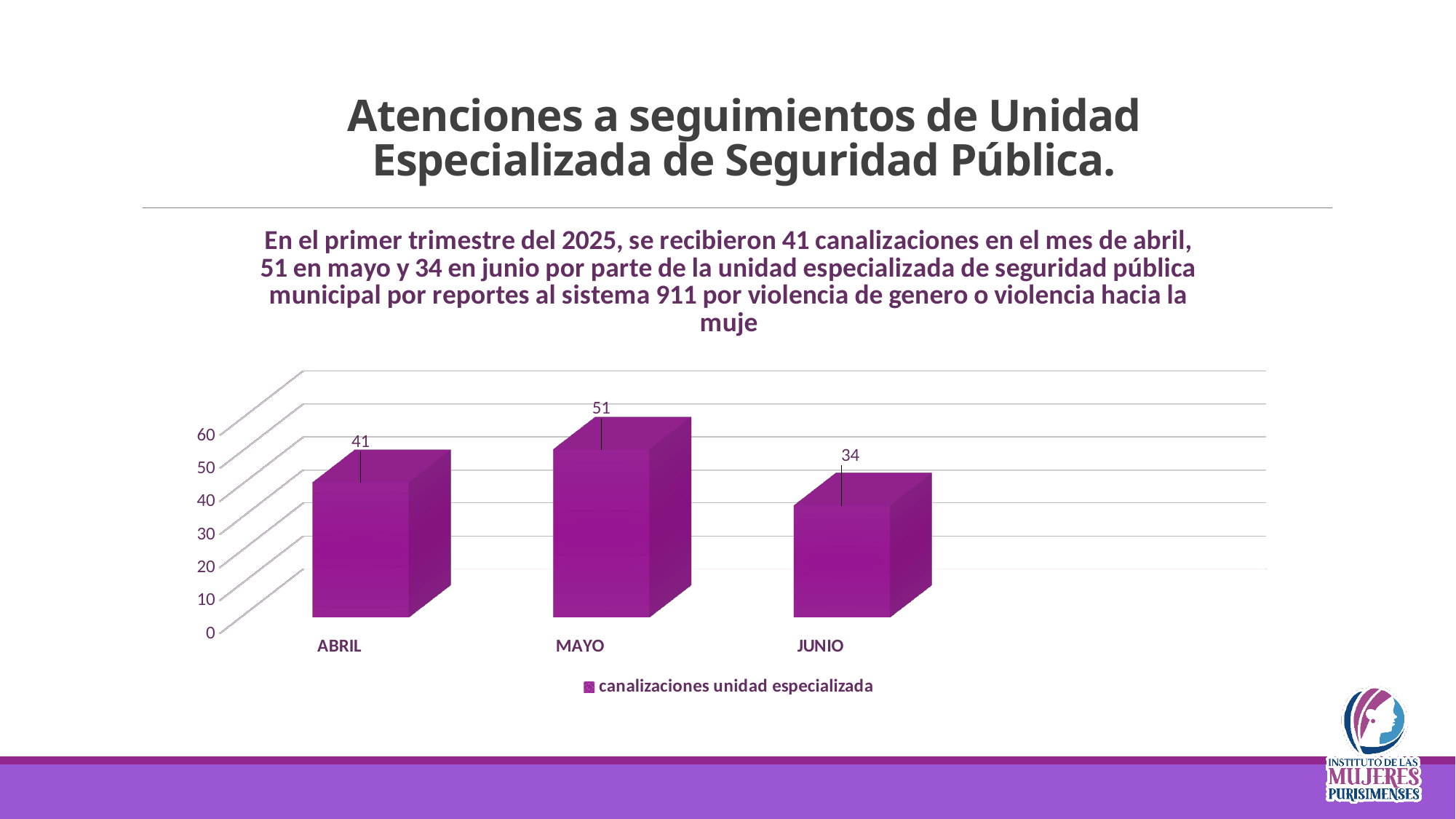
What series name does the legend show? canalizaciones unidad especializada Which month has the lowest value? JUNIO Is the value for MAYO greater or less than 50? greater How many months are shown on the x axis? 3 What is the value for JUNIO? 34 Which month has the highest value? MAYO What is the difference between the values for ABRIL and JUNIO? 7 What is the value for ABRIL? 41 What is the difference between the values for MAYO and ABRIL? 10 What kind of chart is shown on the slide? bar chart Which is larger, the value for ABRIL or the value for JUNIO? ABRIL What is the value for MAYO? 51